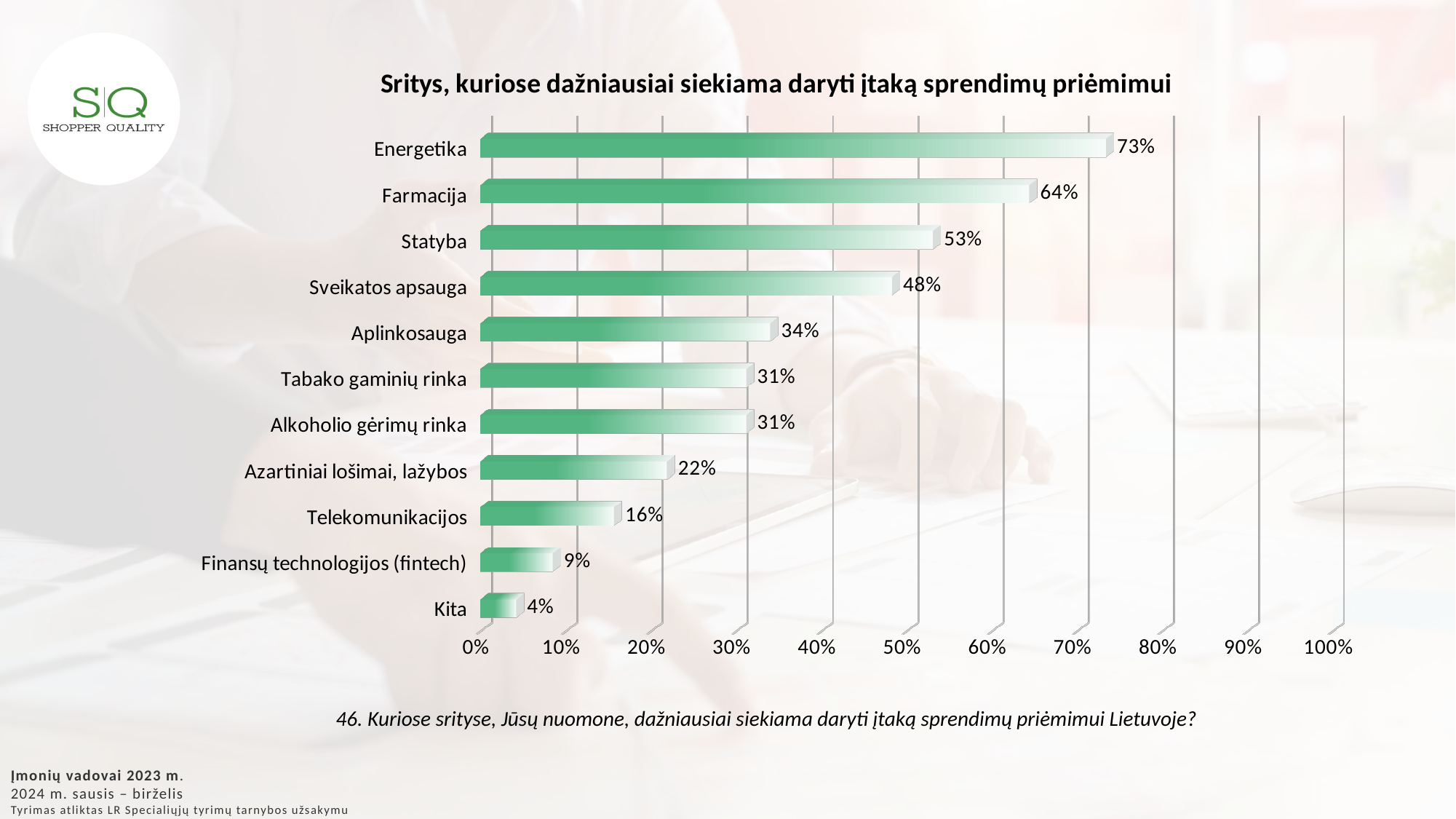
Is the value for Farmacija greater or less than 60%? greater What kind of chart is shown on the slide? bar chart What is the value for Energetika? 73% How many categories are shown in the chart? 11 What is the value for Telekomunikacijos? 16% What is the difference between the values for Statyba and Aplinkosauga? 19% Which is larger, the value for Azartiniai lošimai, lažybos or the value for Finansų technologijos (fintech)? Azartiniai lošimai, lažybos What is the value for Sveikatos apsauga? 48% Which category has the highest value? Energetika What is the difference between the values for Energetika and Farmacija? 9% Which category has the lowest value? Kita What is the title of the chart? Sritys, kuriose dažniausiai siekiama daryti įtaką sprendimų priėmimui